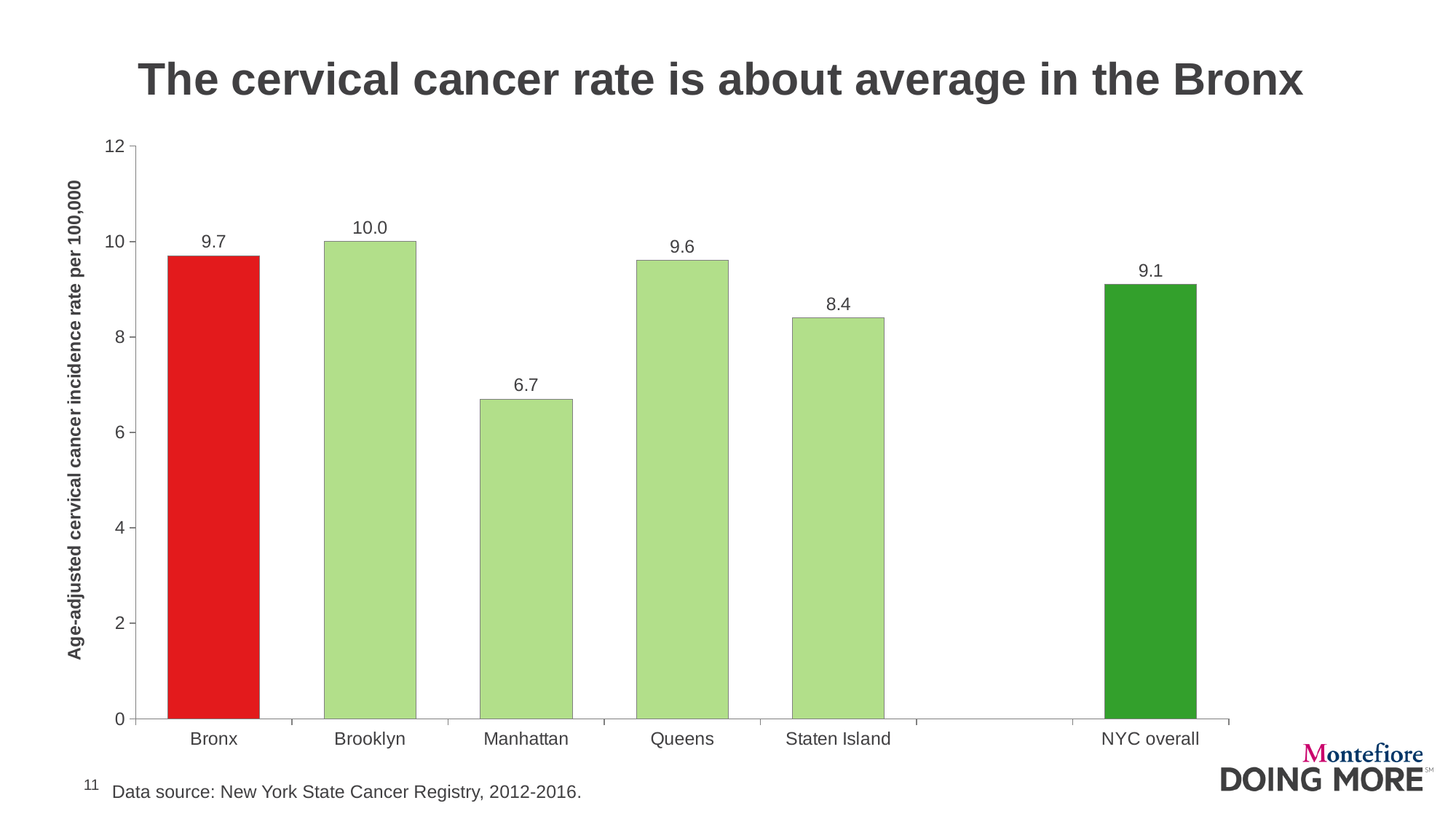
Which bar is coloured red? Bronx Which borough has the lowest cervical cancer incidence rate? Manhattan Is the value for Staten Island greater or less than 8? greater How many bars are plotted in the chart? 6 Which has a higher cervical cancer incidence rate, Queens or Staten Island? Queens What is the age-adjusted cervical cancer incidence rate per 100,000 for the Bronx? 9.7 What is the cervical cancer incidence rate shown for Manhattan? 6.7 What is the cervical cancer incidence rate shown for NYC overall? 9.1 What is the difference between the cervical cancer incidence rates for Brooklyn and Manhattan? 3.3 Which borough has the highest cervical cancer incidence rate? Brooklyn What kind of chart is shown on the slide? Bar chart What is the difference between the Bronx rate and the NYC overall rate? 0.6